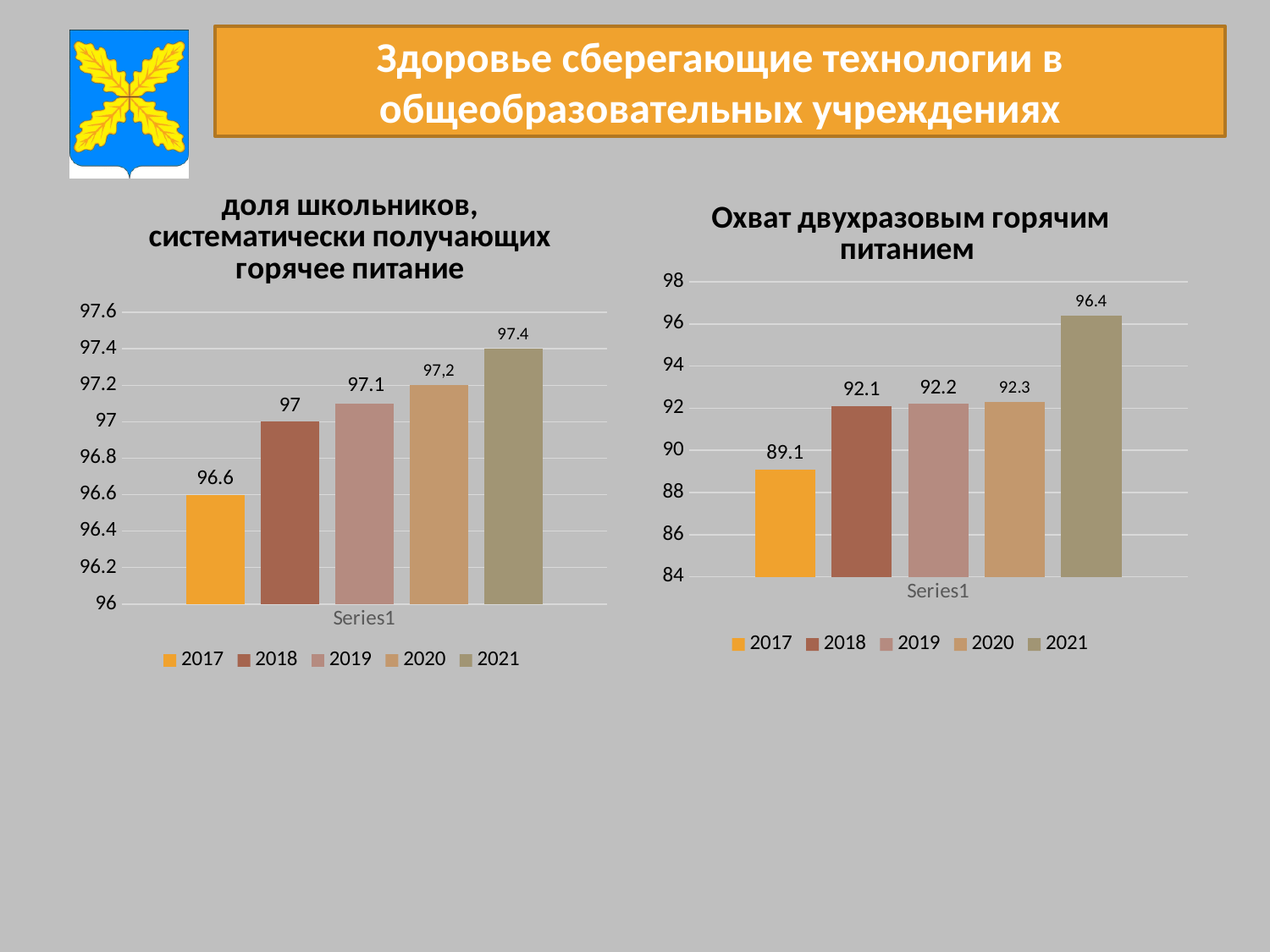
In the left chart (доля школьников, систематически получающих горячее питание), do the values rise or fall from 2017 to 2021? rise In the right chart (Охват двухразовым горячим питанием), which year has the lowest value? 2017 What kind of chart is the right chart (Охват двухразовым горячим питанием)? bar chart In the right chart (Охват двухразовым горячим питанием), what is the value for 2021? 96.4 In the right chart (Охват двухразовым горячим питанием), what is the value for 2017? 89.1 In the left chart (доля школьников, систематически получающих горячее питание), what is the value for 2017? 96.6 In the left chart (доля школьников, систематически получающих горячее питание), which year has the highest value? 2021 In the right chart (Охват двухразовым горячим питанием), is the value for 2018 larger or smaller than the value for 2021? smaller In the right chart (Охват двухразовым горячим питанием), what is the difference between the values for 2021 and 2017? 7.3 How many series does the legend of the left chart list? 5 In the left chart (доля школьников, систематически получающих горячее питание), what is the value for 2020? 97,2 In the left chart (доля школьников, систематически получающих горячее питание), what is the difference between the values for 2021 and 2017? 0.8